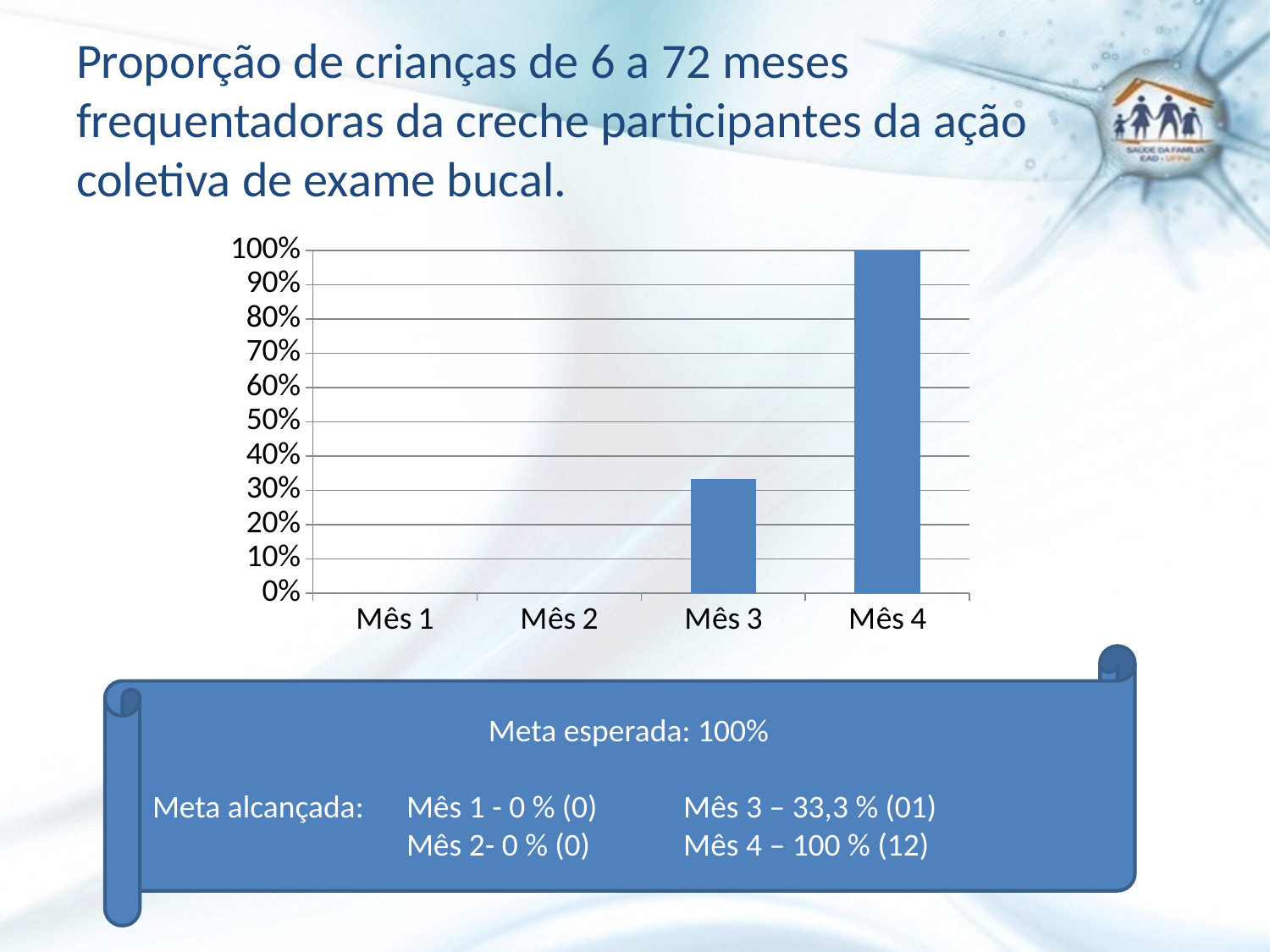
What is the expected target (meta esperada) stated on the slide? 100% How many categories (months) are shown on the x axis of the chart? 4 Do the values rise or fall from Mês 1 to Mês 4? rise What is the value for Mês 4 in the chart? 100% Which month has the highest value in the chart? Mês 4 What is the difference between the values for Mês 4 and Mês 3? 66,7 % What is the value for Mês 1 in the chart? 0% Is the value for Mês 4 greater or less than 90%? greater What is the value for Mês 3 according to the slide? 33,3 % Which is larger, the value for Mês 3 or the value for Mês 4? Mês 4 Is the value for Mês 3 greater or less than 50%? less What type of chart is shown on the slide? bar chart